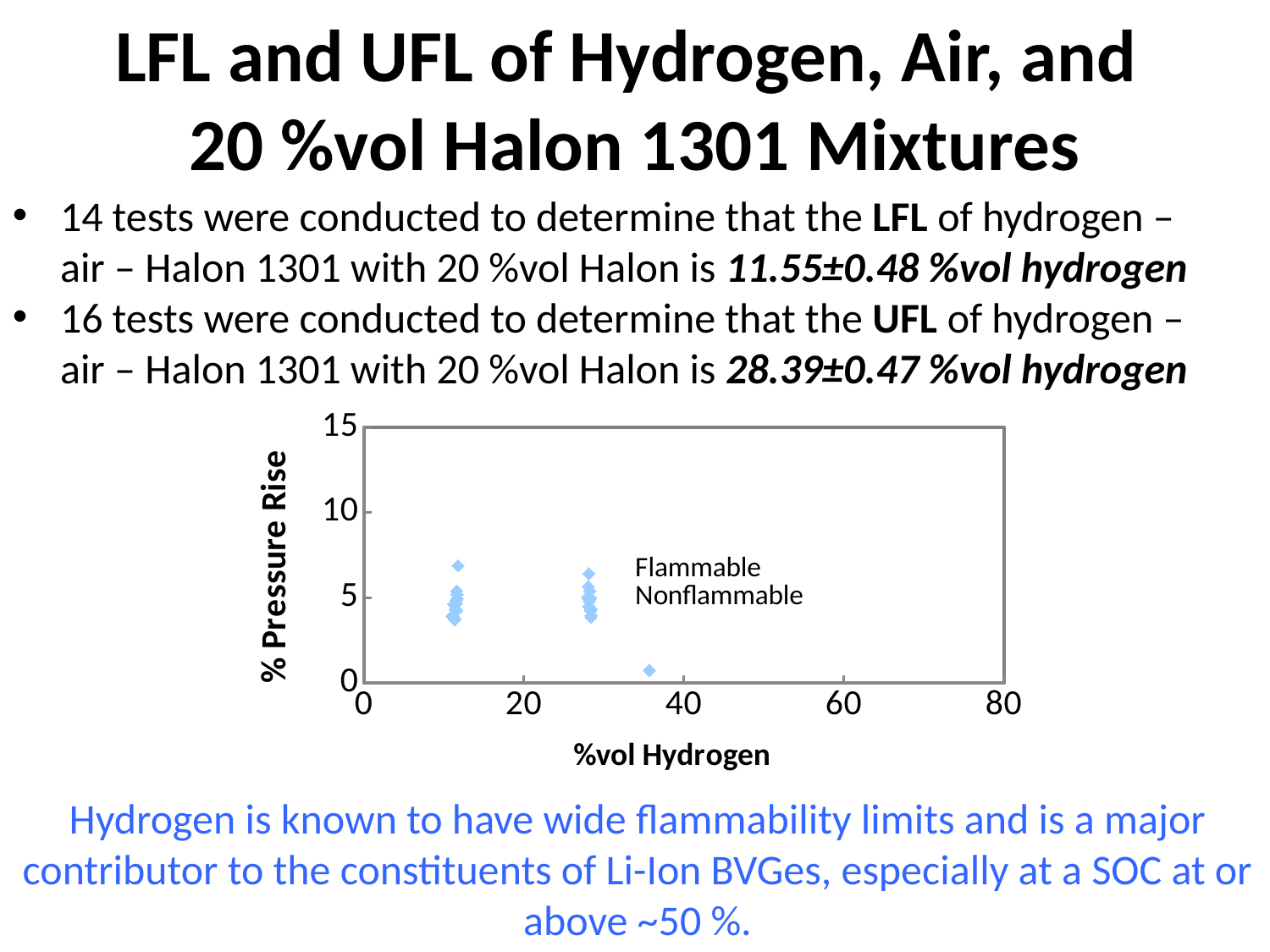
Is the % pressure rise of the isolated point near 36 %vol hydrogen larger or smaller than that of the points clustered near 28 %vol hydrogen? smaller Is the % pressure rise of the isolated point near 36 %vol hydrogen greater or less than 5? less Which has the lowest % pressure rise: the cluster near 12 %vol hydrogen, the cluster near 28 %vol hydrogen, or the isolated point near 36 %vol hydrogen? the isolated point near 36 %vol hydrogen What is the title of the chart's x axis? %vol Hydrogen What kind of chart is shown on the slide? scatter chart Are the % pressure rise values of the points clustered near 12 %vol hydrogen greater or less than 10? less Are the % pressure rise values of the points clustered near 28 %vol hydrogen greater or less than 10? less